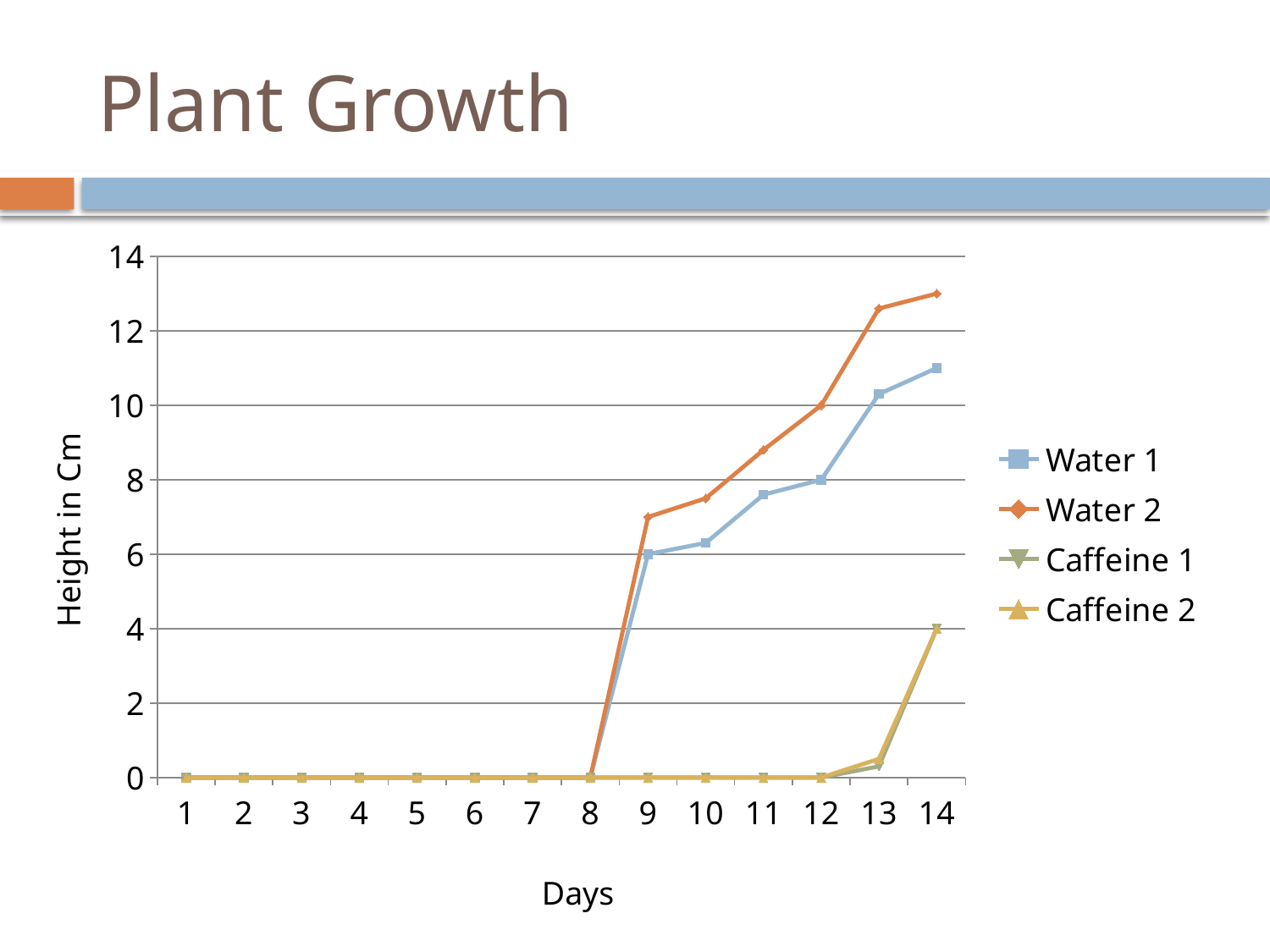
How many series does the legend list? 4 What is the height for Water 1 on day 8? 0 Is the value for Water 1 on day 14 greater or less than 12? less How many days are shown along the x axis? 14 What is the label of the y axis? Height in Cm What is the height for Water 2 on day 12? 10 What is the height for Water 1 on day 12? 8 What kind of chart is shown on the slide? line chart Do the Water 2 values rise or fall from day 9 to day 14? rise Which series has the highest height on day 14? Water 2 Which is larger on day 11, Water 2 or Water 1? Water 2 Is the value for Water 2 on day 14 greater or less than 12? greater